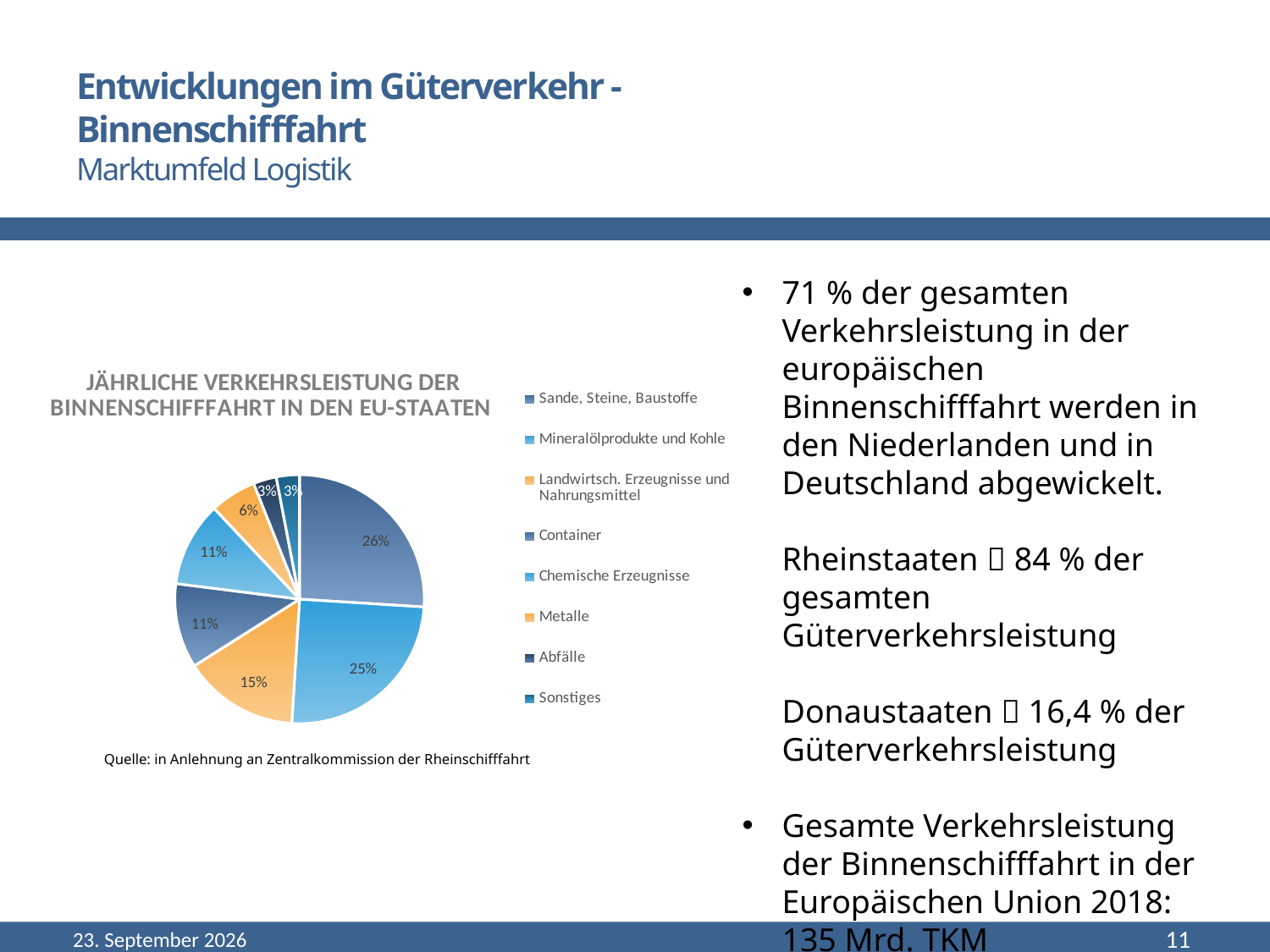
What is the source given below the chart? Quelle: in Anlehnung an Zentralkommission der Rheinschifffahrt Which category has the largest slice of the pie? Sande, Steine, Baustoffe What is the difference in percentage points between 'Sande, Steine, Baustoffe' and 'Mineralölprodukte und Kohle'? 1 percentage point What type of chart is shown on the slide? pie chart What is the value shown for 'Mineralölprodukte und Kohle'? 25% How many categories does the legend of the pie chart list? 8 What is the title of the chart? JÄHRLICHE VERKEHRSLEISTUNG DER BINNENSCHIFFFAHRT IN DEN EU-STAATEN What is the value shown for 'Metalle'? 6% What is the value shown for 'Landwirtsch. Erzeugnisse und Nahrungsmittel'? 15% Which is larger, the slice for 'Landwirtsch. Erzeugnisse und Nahrungsmittel' or the slice for 'Metalle'? Landwirtsch. Erzeugnisse und Nahrungsmittel What is the difference in percentage points between 'Landwirtsch. Erzeugnisse und Nahrungsmittel' and 'Metalle'? 9 percentage points What share of the pie does 'Sande, Steine, Baustoffe' have? 26%